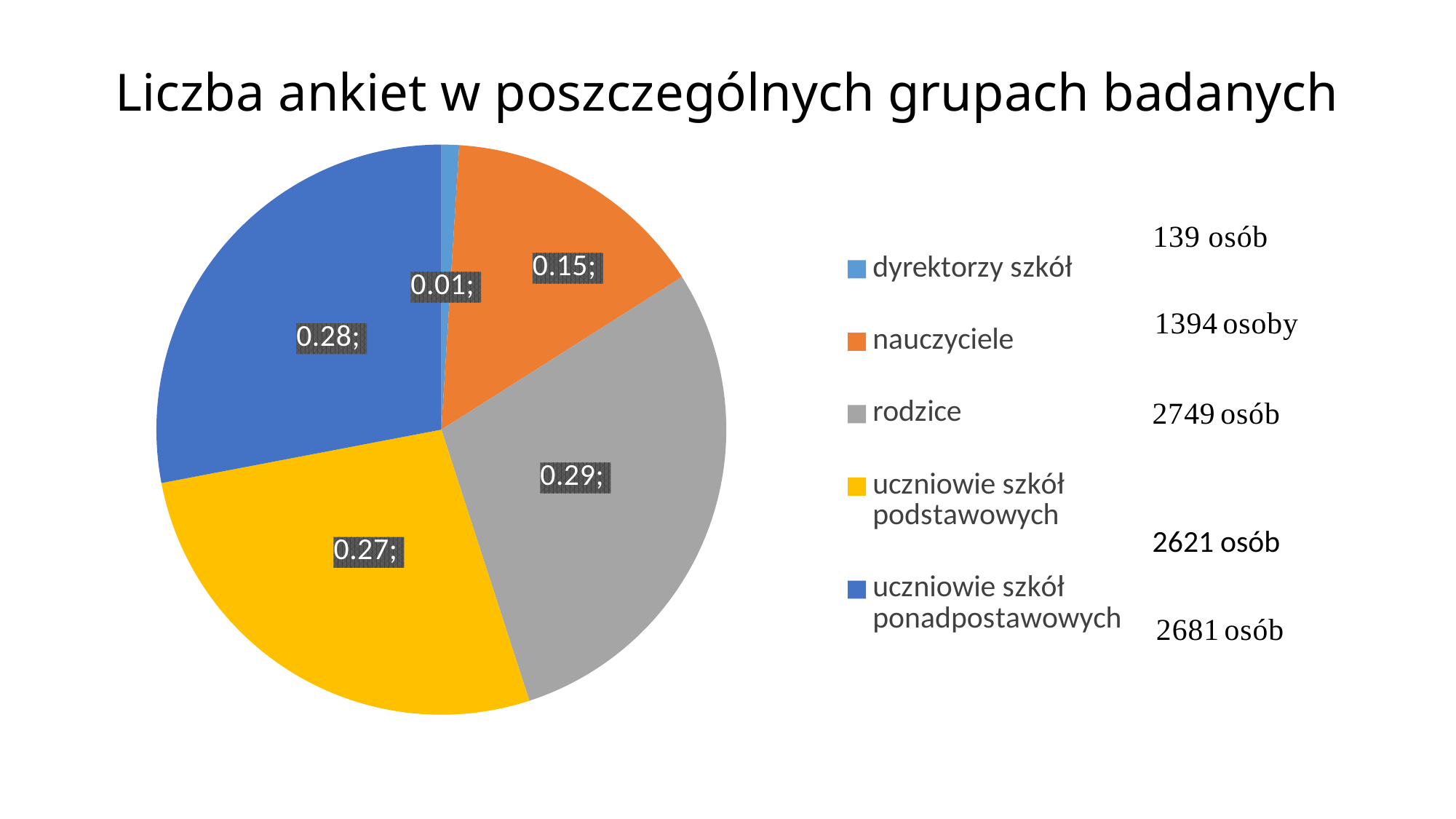
Which category has the largest slice of the pie? rodzice Which category has the smallest slice of the pie? dyrektorzy szkół What share of the pie is labelled for rodzice? 0.29 What is the difference between the labelled shares for rodzice and nauczyciele? 0.14 What kind of chart is shown on the slide? pie chart Which slice is larger: nauczyciele or uczniowie szkół podstawowych? uczniowie szkół podstawowych What share of the pie is labelled for nauczyciele? 0.15 What colour is the slice for uczniowie szkół podstawowych? yellow What is the title of the chart? Liczba ankiet w poszczególnych grupach badanych What share of the pie is labelled for uczniowie szkół ponadpostawowych? 0.28 How many categories does the pie chart have? 5 What share of the pie is labelled for dyrektorzy szkół? 0.01